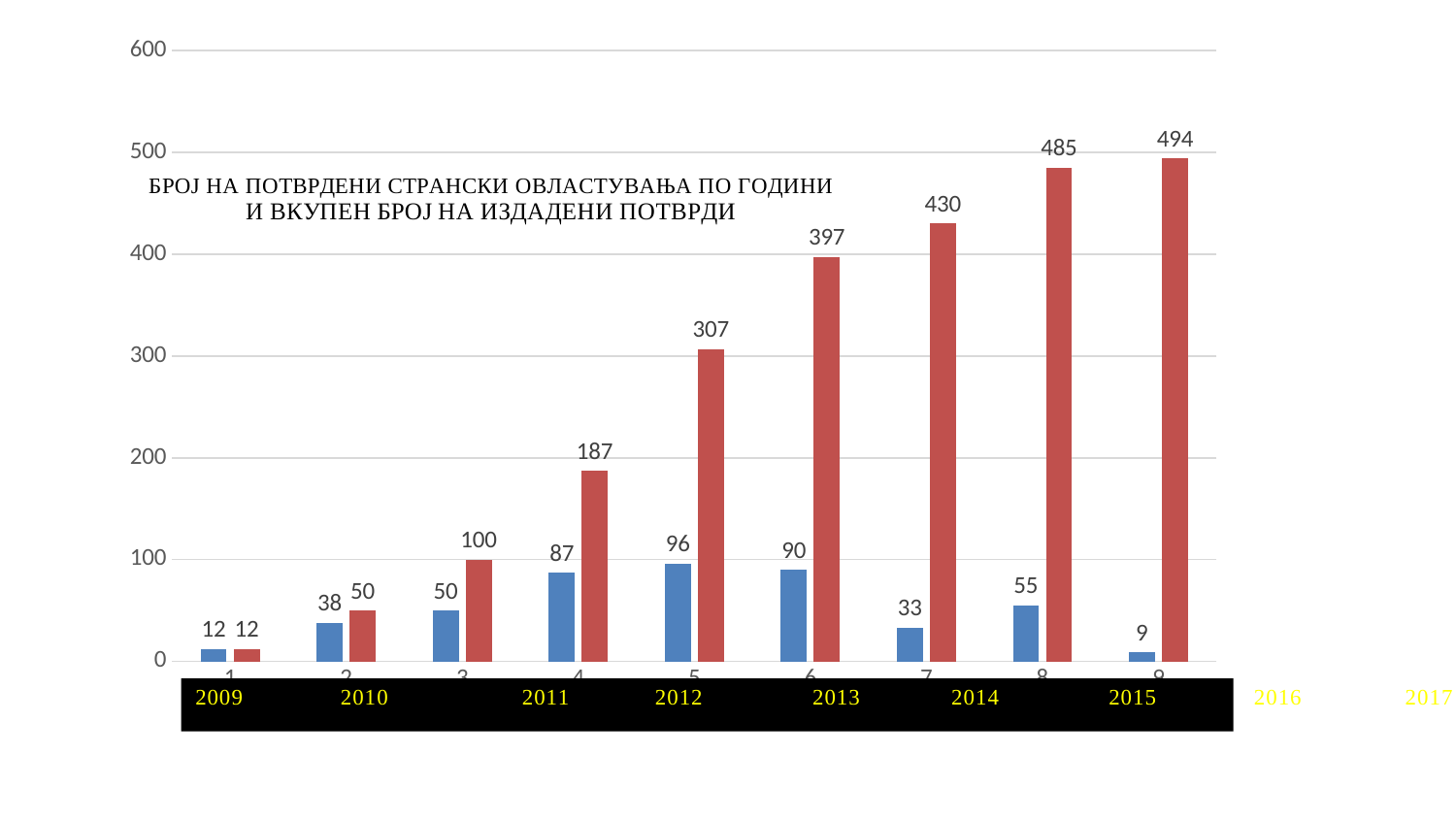
How many categories (pairs of bars) are plotted along the x axis? 9 What is the difference between the red bars in the ninth and eighth categories? 9 What is the lowest value among the blue bars? 9 What is the difference between the red bar and the blue bar in the sixth category? 307 What is the title of the chart? БРОЈ НА ПОТВРДЕНИ СТРАНСКИ ОВЛАСТУВАЊА ПО ГОДИНИ И ВКУПЕН БРОЈ НА ИЗДАДЕНИ ПОТВРДИ What kind of chart is shown on the slide? bar chart Which is larger, the blue bar in the fifth category or the blue bar in the sixth category? the fifth category (96) What is the highest value among the red bars? 494 Do the red bars rise or fall from left to right along the x axis? rise What is the value of the red bar in the fourth category? 187 What is the value of the blue bar in the second category? 38 What is the highest value among the blue bars? 96